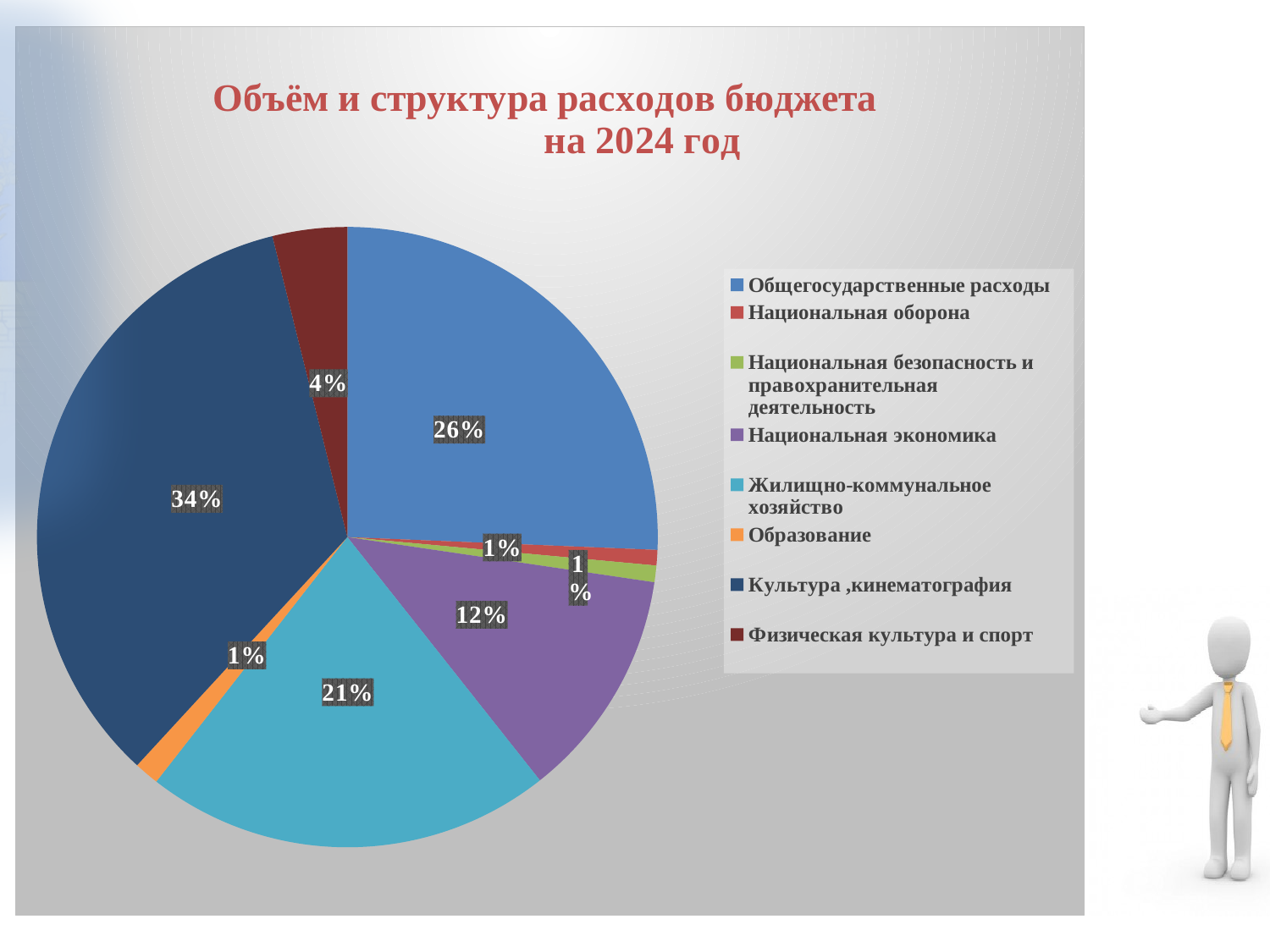
Which category has the largest share of the pie? Культура ,кинематография What share of the pie does Общегосударственные расходы have? 26% What is the difference between the share for Культура ,кинематография and the share for Национальная экономика? 22% What is the title of the chart? Объём и структура расходов бюджета на 2024 год What share of the pie does Образование have? 1% What share of the pie does Культура ,кинематография have? 34% How many categories does the legend list? 8 Which is larger, the share for Общегосударственные расходы or the share for Жилищно-коммунальное хозяйство? Общегосударственные расходы What kind of chart is shown on the slide? Pie chart